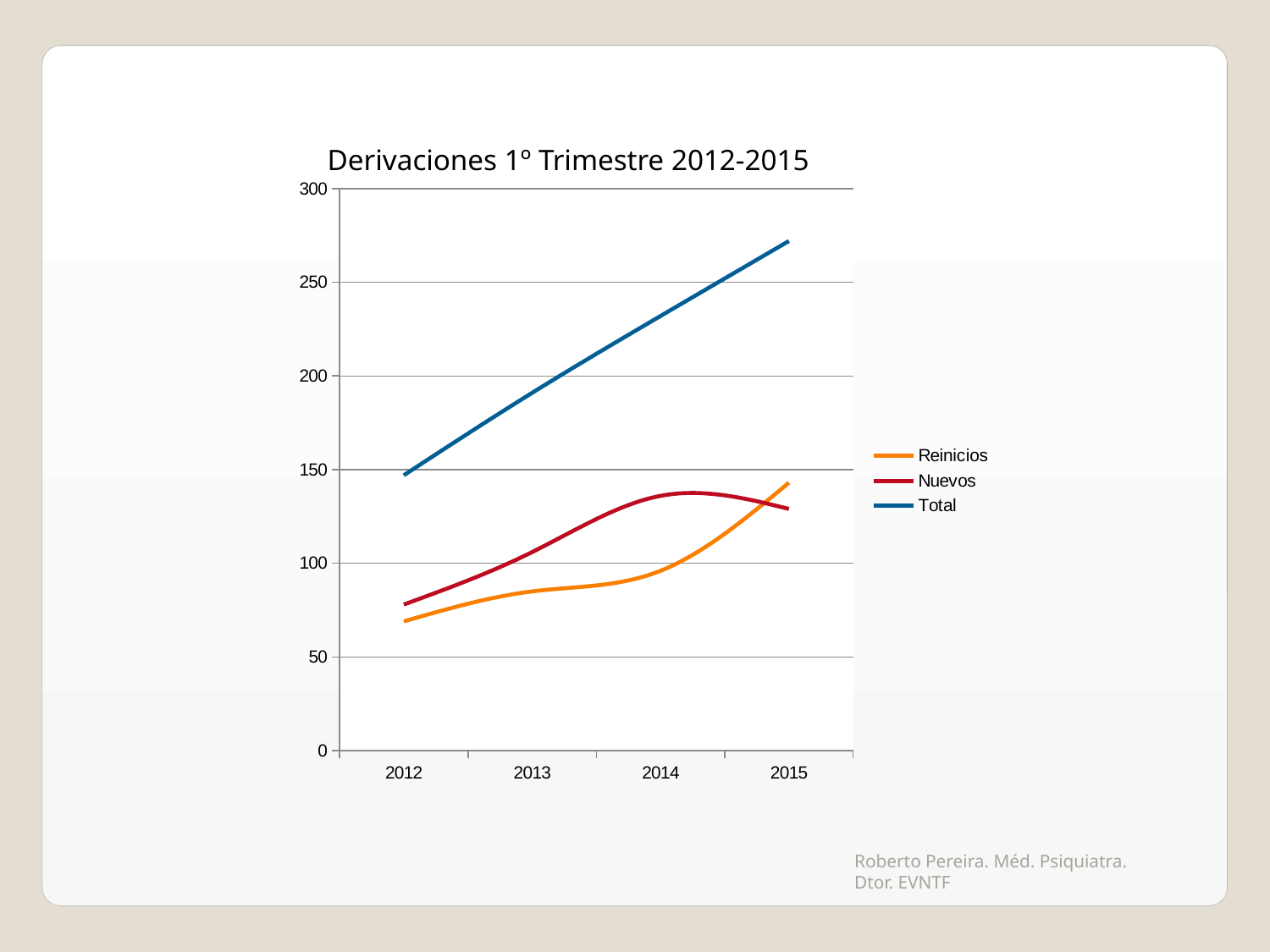
How many years are shown on the x axis? 4 What is the title of the chart? Derivaciones 1º Trimestre 2012-2015 In which year is the Reinicios series lowest? 2012 Is the value for Nuevos in 2014 greater or less than 100? greater Which series has the larger value in 2015, Reinicios or Nuevos? Reinicios Which series has the larger value in 2013, Nuevos or Reinicios? Nuevos Is the value for Total in 2013 greater or less than 200? less How many series does the legend list? 3 Does the Total series rise or fall from 2012 to 2015? rise Is the value for Total in 2015 greater or less than 250? greater What kind of chart is shown on the slide? line chart In which year is the Total series highest? 2015